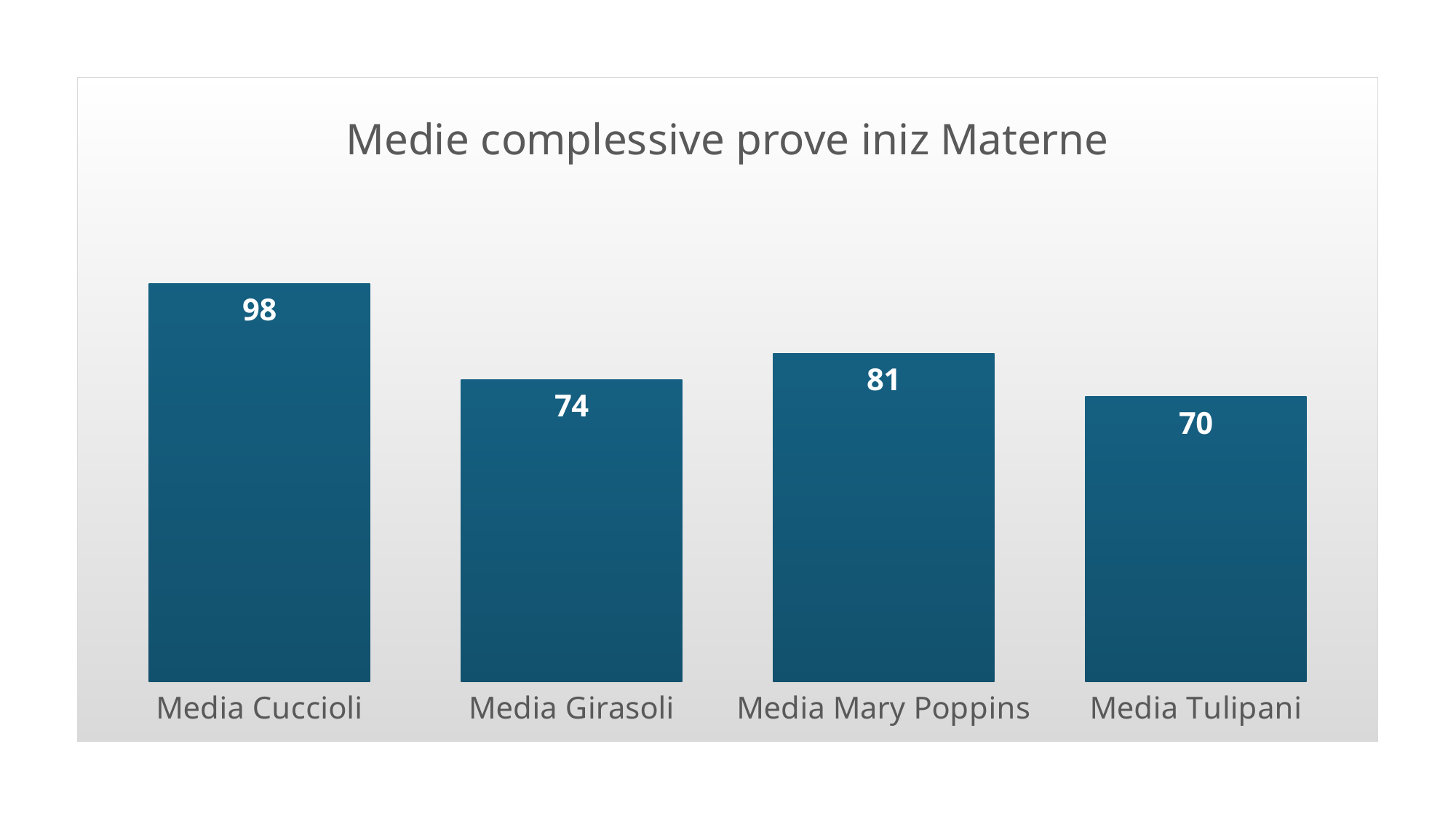
How many categories are shown in the chart? 4 What is the value for Media Tulipani? 70 Which is larger, the value for Media Girasoli or the value for Media Mary Poppins? Media Mary Poppins Which category has the highest value? Media Cuccioli What is the value for Media Cuccioli? 98 Which category has the lowest value? Media Tulipani What is the title of the chart? Medie complessive prove iniz Materne What kind of chart is shown on the slide? Bar chart What is the value for Media Girasoli? 74 What is the value for Media Mary Poppins? 81 What is the difference between the values for Media Cuccioli and Media Tulipani? 28 What is the difference between the values for Media Mary Poppins and Media Girasoli? 7